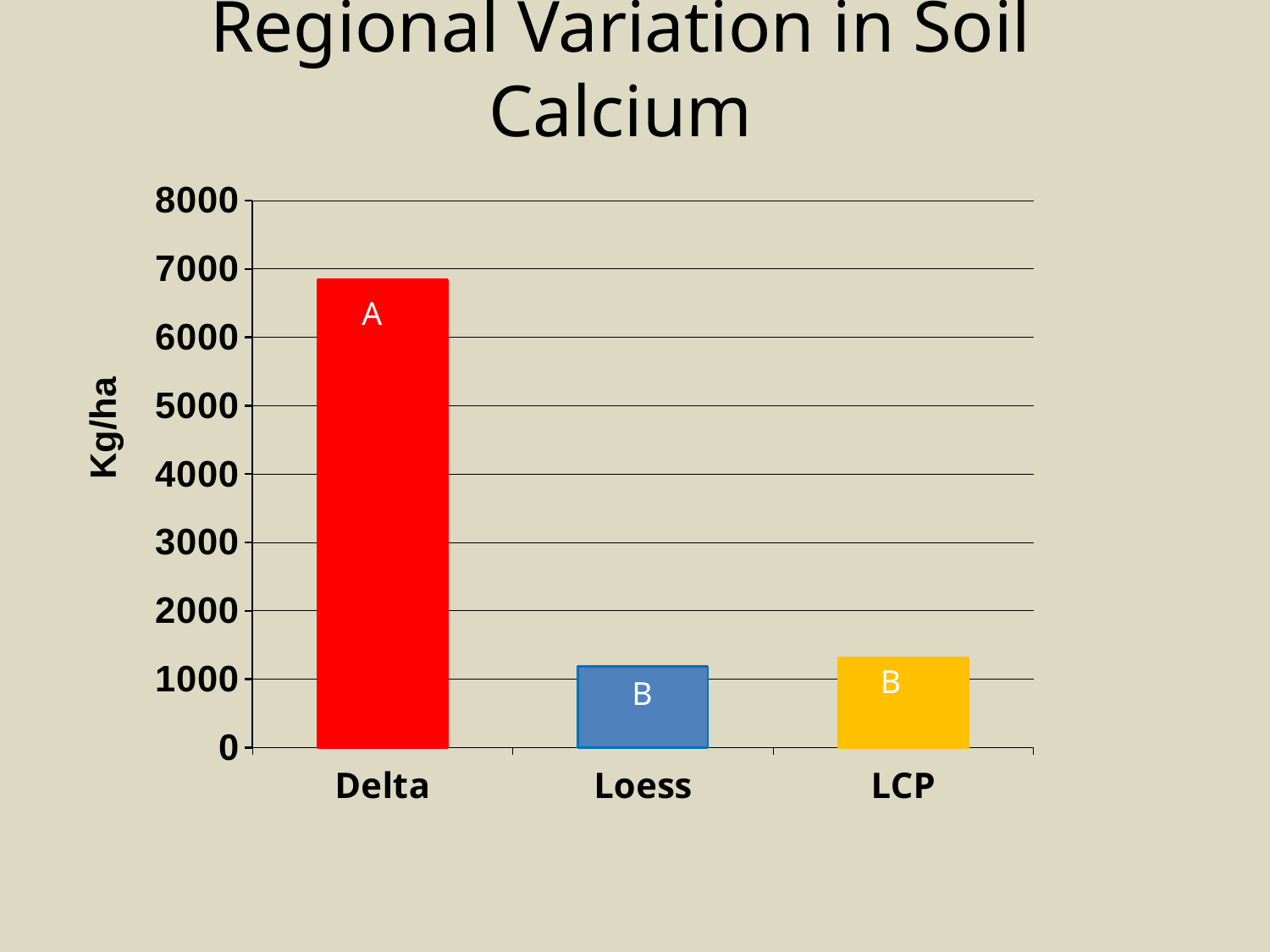
How many regions are plotted on the chart? 3 Which is larger, the value for Delta or the value for LCP? Delta Is the value for Delta greater or less than 6000? greater Is the value for Loess greater or less than 2000? less What kind of chart is shown on the slide? bar chart What is the label on the vertical axis of the chart? Kg/ha Which is larger, the value for Delta or the value for Loess? Delta Is the value for Delta greater or less than 7000? less What letter is printed on the Delta bar? A Which region has the highest soil calcium value? Delta